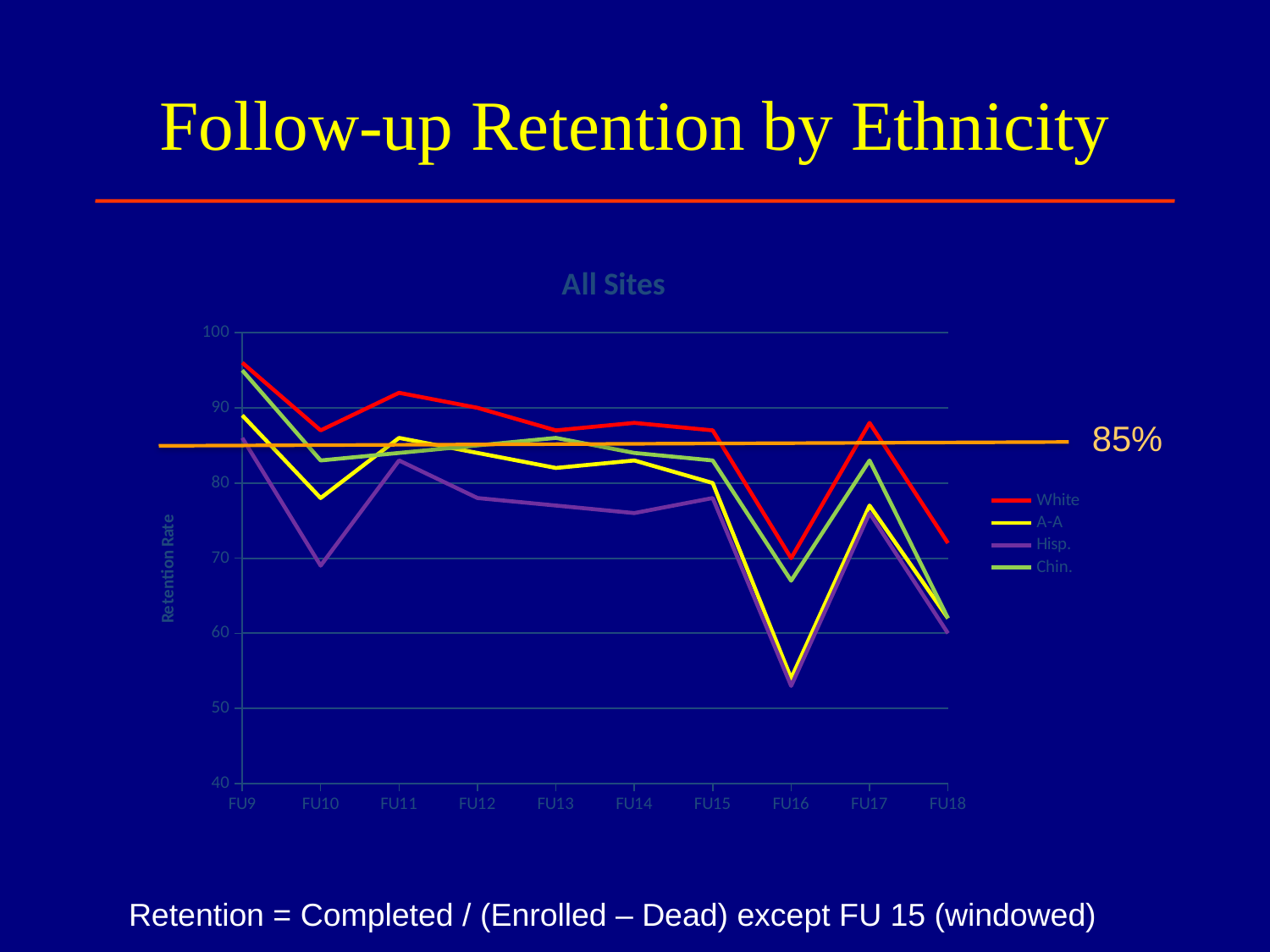
Which series has the highest retention rate at FU12? White What value does the horizontal orange reference line mark? 85% Is the value for Hisp. at FU16 greater or less than 60? less How many series does the legend list? 4 Is the value for White at FU18 greater or less than 80? less What is the title shown above the chart? All Sites Which series has the lowest retention rate at FU10? Hisp. What kind of chart is shown on the slide? line chart Is the value for White at FU9 greater or less than 90? greater At FU16, which is larger: the value for White or the value for A-A? White How many follow-up points are plotted along the x axis? 10